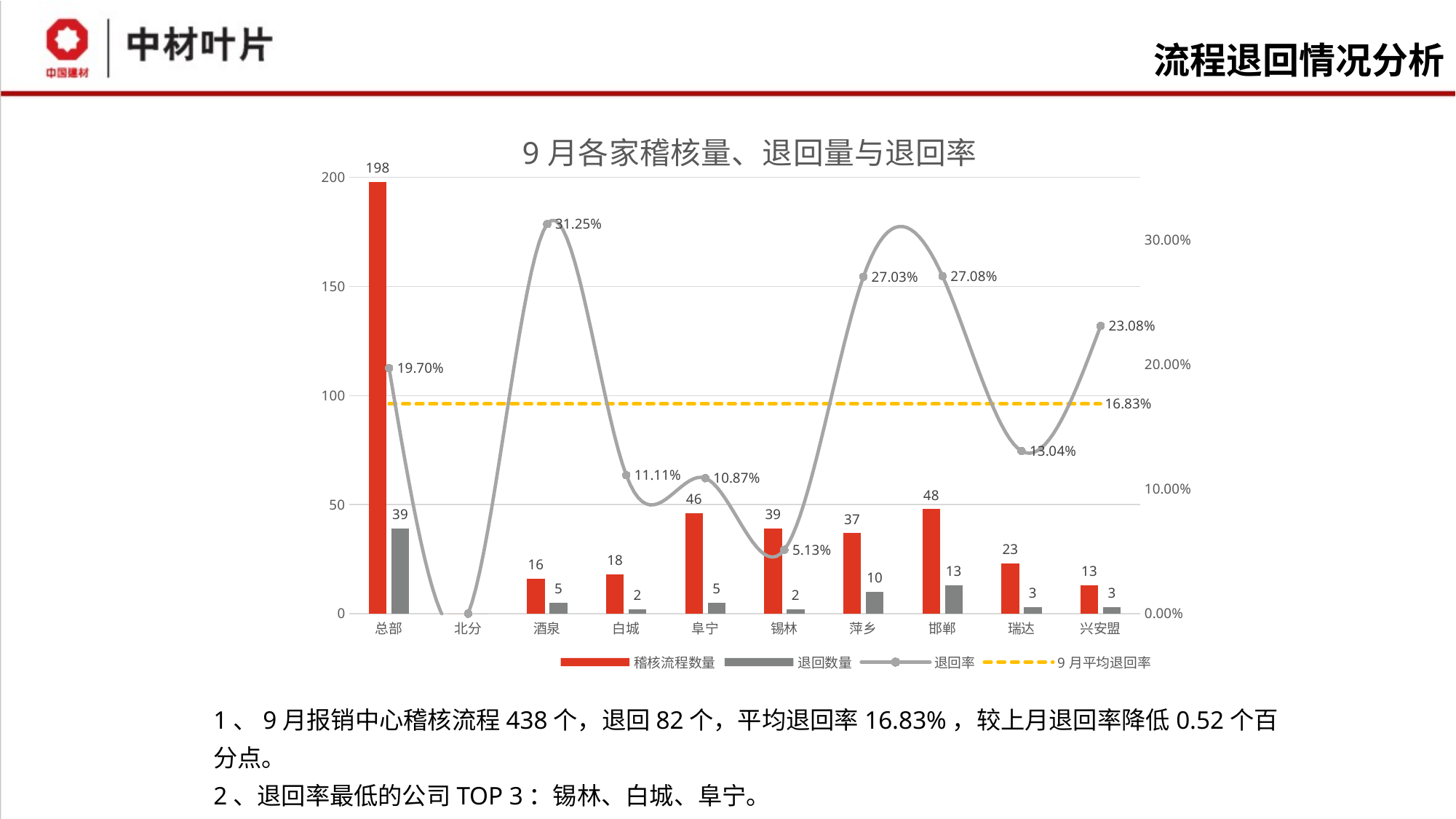
What value does the dashed 9月平均退回率 line show? 16.83% Which is larger, the 退回数量 for 萍乡 or for 瑞达? 萍乡 How many categories are shown on the x axis? 10 Which category has the highest 退回率? 酒泉 What is the 稽核流程数量 value for 总部? 198 Which category has the lowest 稽核流程数量 among those with a labelled bar? 兴安盟 What is the 退回率 for 酒泉? 31.25% What is the title of the chart? 9月各家稽核量、退回量与退回率 What is the 退回率 for 锡林? 5.13% What is the difference between the 稽核流程数量 for 邯郸 and for 阜宁? 2 How many series does the legend list? 4 What is the 退回数量 value for 邯郸? 13